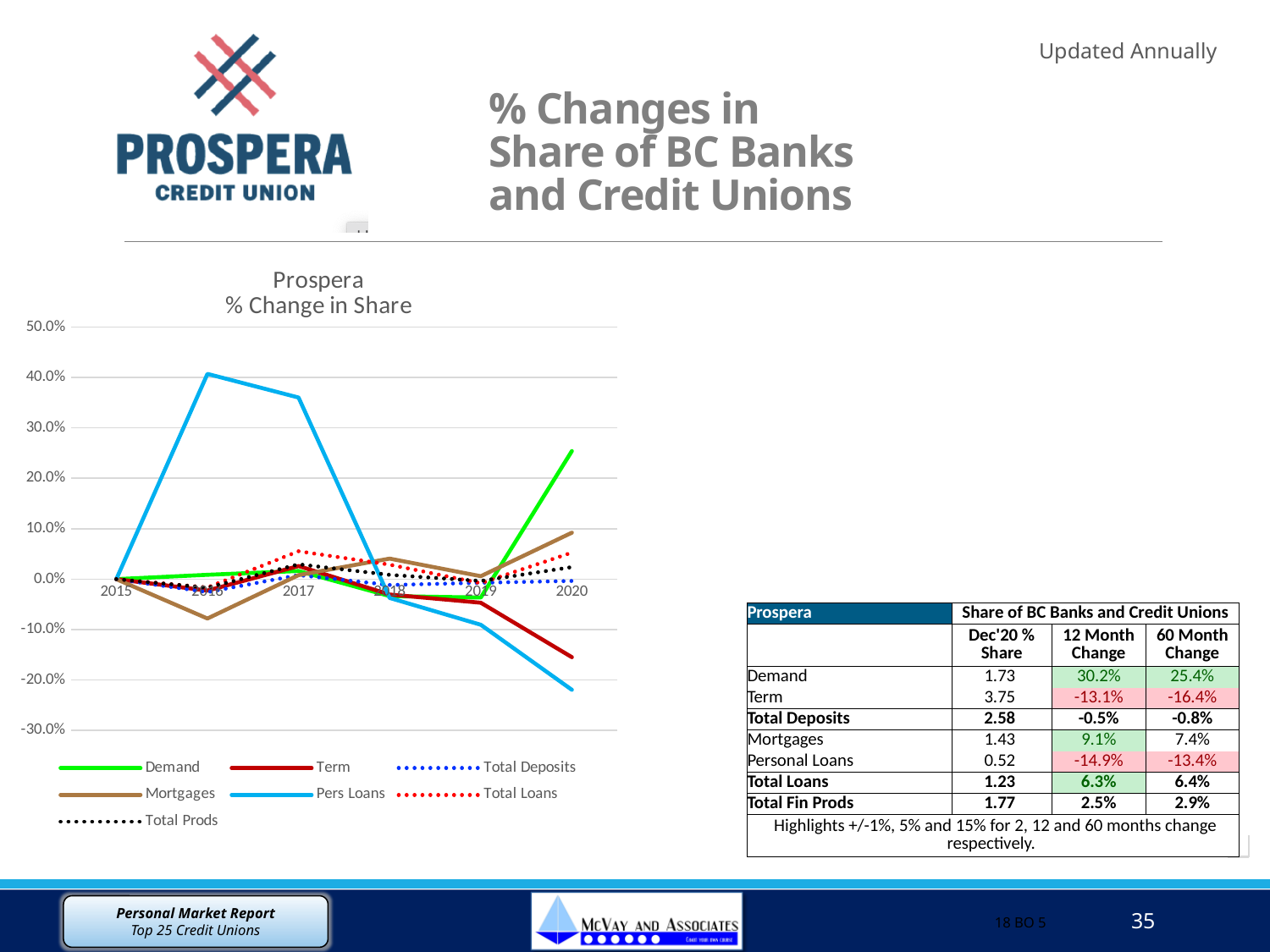
Is the value for Pers Loans in 2020 greater or less than -10.0%? less Which series reaches the highest point anywhere on the chart? Pers Loans Which series has the lowest value in 2020? Pers Loans Is the value for Term in 2020 greater or less than -10.0%? less How many years are shown along the x axis of the chart? 6 Is the value for Pers Loans in 2016 greater or less than 30.0%? greater How many series does the legend of the Prospera % Change in Share chart list? 7 What kind of chart is shown on the slide? line chart Does the Pers Loans line rise or fall from 2017 to 2020? fall In 2016, which is larger: the value for Pers Loans or the value for Mortgages? Pers Loans Which series has the highest value in 2020? Demand